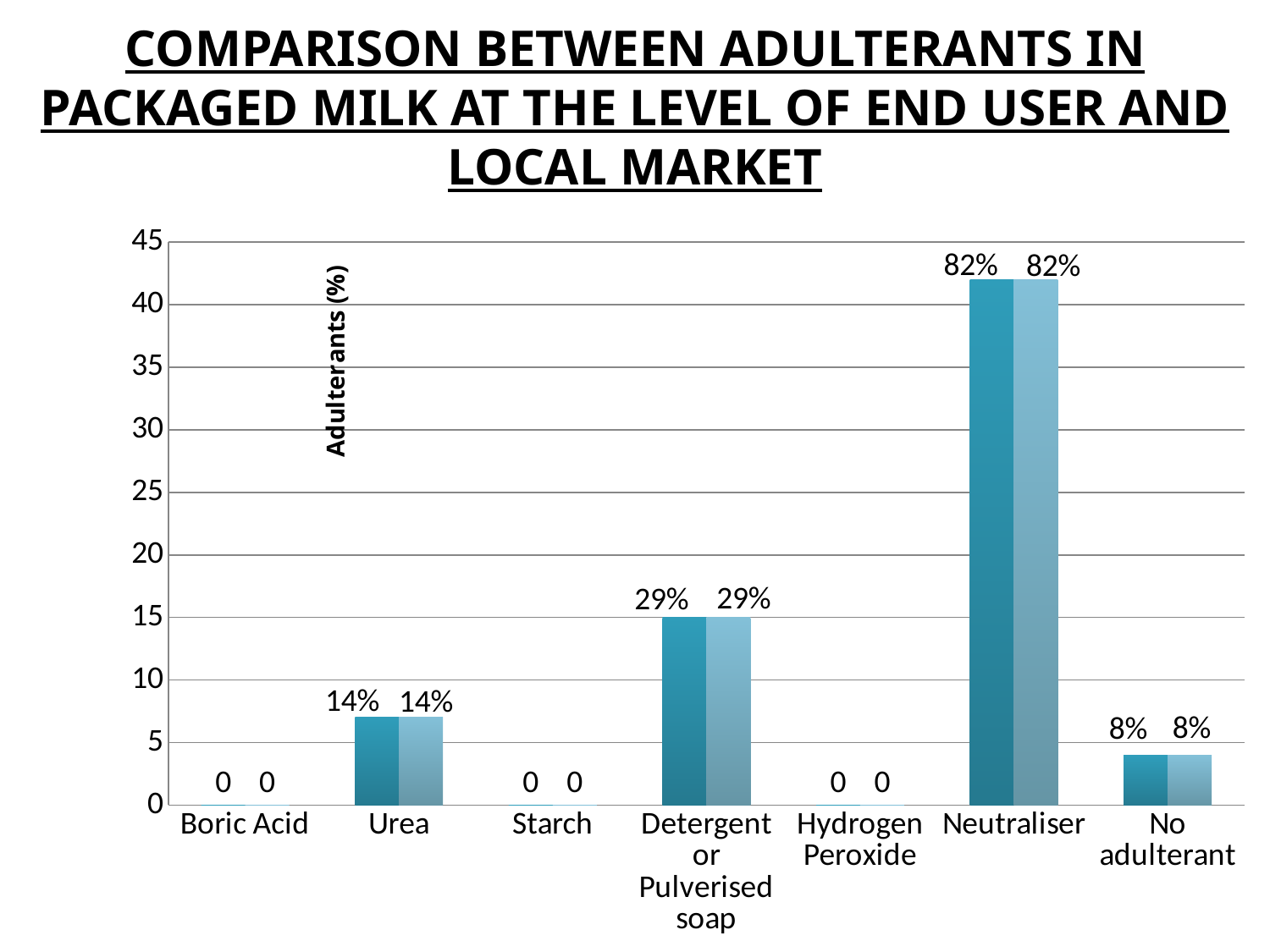
Which adulterant category has the highest bars? Neutraliser Which has higher bars: Detergent or Pulverised soap, or No adulterant? Detergent or Pulverised soap How many bars are plotted for each category? 2 What data label is shown on the bars for Neutraliser? 82% Is the bar height for Neutraliser greater or less than 40 on the y axis? greater Is the bar height for Detergent or Pulverised soap greater or less than 20 on the y axis? less What is the title of the y axis? Adulterants (%) What data label is shown on the bars for No adulterant? 8% What data label is shown on the bars for Urea? 14% Which categories have a data label of 0? Boric Acid, Starch, Hydrogen Peroxide What kind of chart is shown on the slide? bar chart How many adulterant categories are shown along the x axis? 7